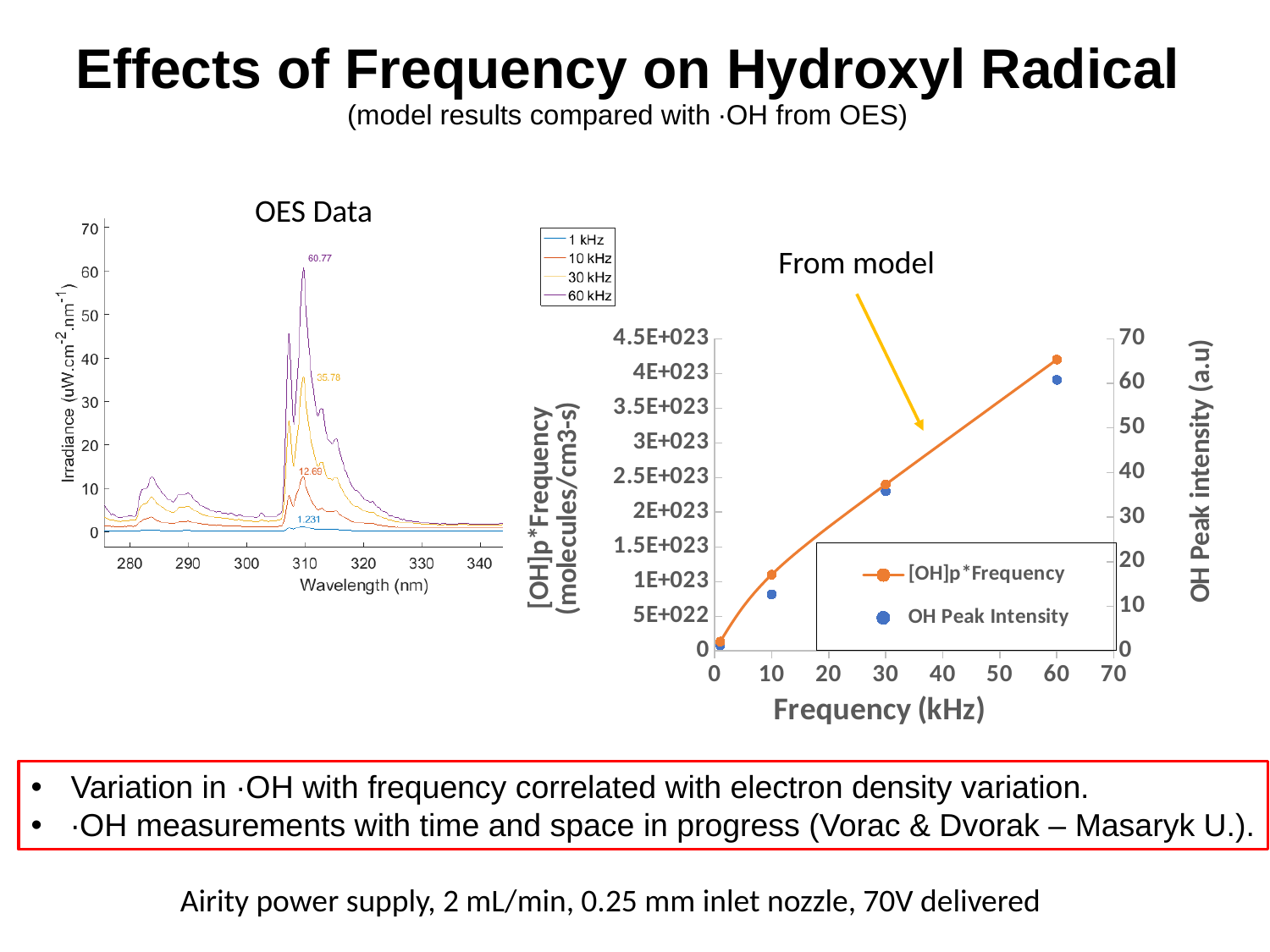
In the OES Data chart on the left, what quantity is plotted on the x axis? Wavelength (nm) In the OES Data chart on the left, what is the difference between the labelled peaks of the 60 kHz and 30 kHz series? 24.99 In the OES Data chart on the left, how many series does the legend list? 4 In the OES Data chart on the left, what is the labelled peak irradiance value for the 1 kHz series? 1.231 In the OES Data chart on the left, what is the labelled peak irradiance value for the 30 kHz series? 35.78 In the OES Data chart on the left, what is the labelled peak irradiance value for the 10 kHz series? 12.69 In the 'From model' chart on the right, is the [OH]p*Frequency value at 10 kHz greater or less than 5E+022? greater In the OES Data chart on the left, which frequency series has the highest labelled peak? 60 kHz In the 'From model' chart on the right, do the [OH]p*Frequency values rise or fall as frequency increases? rise In the OES Data chart on the left, what is the labelled peak irradiance value for the 60 kHz series? 60.77 In the 'From model' chart on the right, how many series does the legend list? 2 In the 'From model' chart on the right, is the OH Peak Intensity value at 60 kHz greater or less than 50? greater